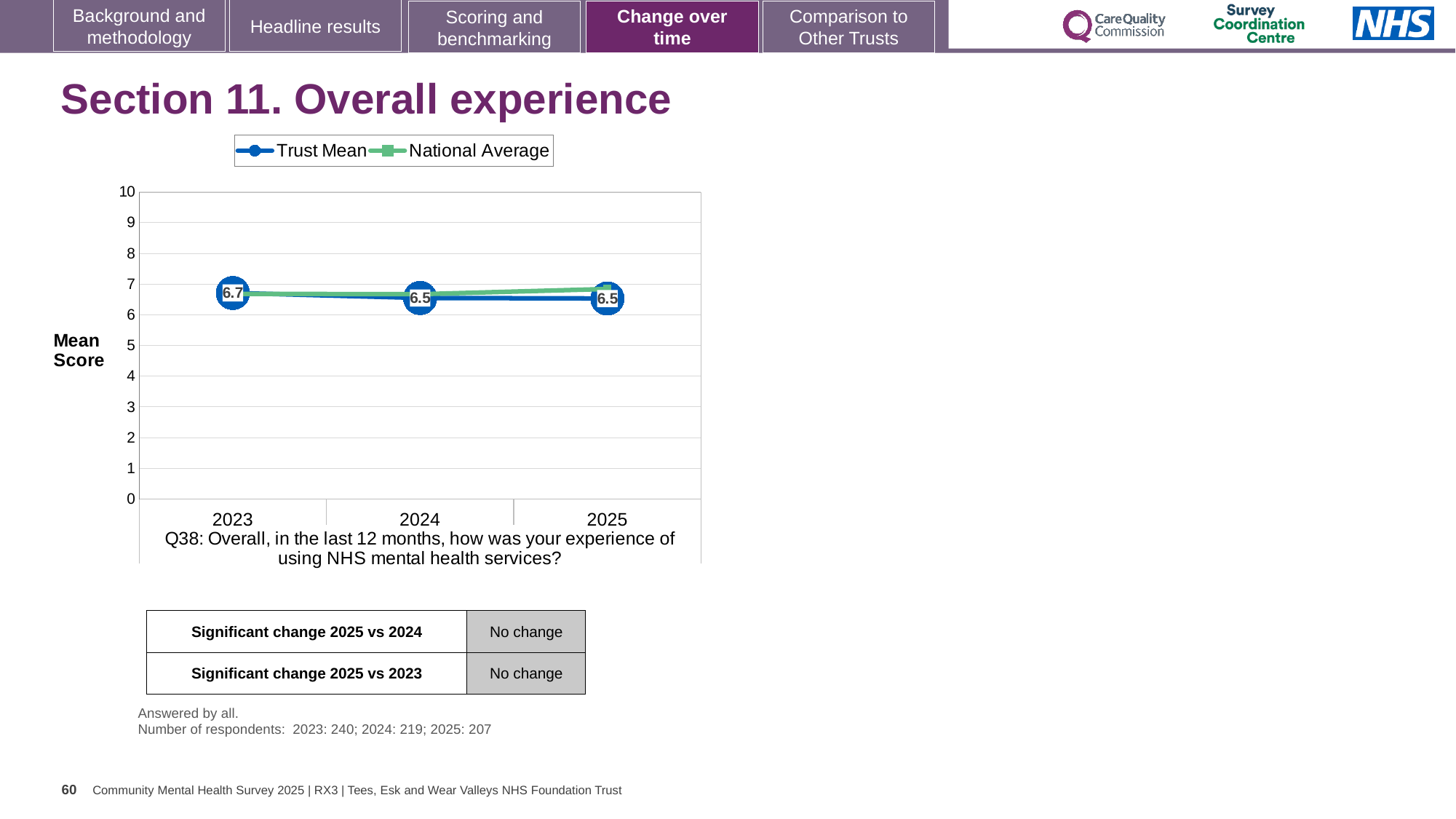
What is the Trust Mean value for 2023? 6.7 Which is larger, the Trust Mean for 2023 or the Trust Mean for 2025? 2023 How many series does the legend list? 2 What is the label on the y axis of the chart? Mean Score How many years are plotted on the x axis? 3 What is the Trust Mean value for 2025? 6.5 Is the National Average value for 2025 greater or less than 5? greater In which year is the Trust Mean highest? 2023 What kind of chart is shown on the slide? Line chart Does the Trust Mean rise or fall from 2023 to 2025? Fall What is the difference between the Trust Mean in 2023 and in 2024? 0.2 What is the Trust Mean value for 2024? 6.5